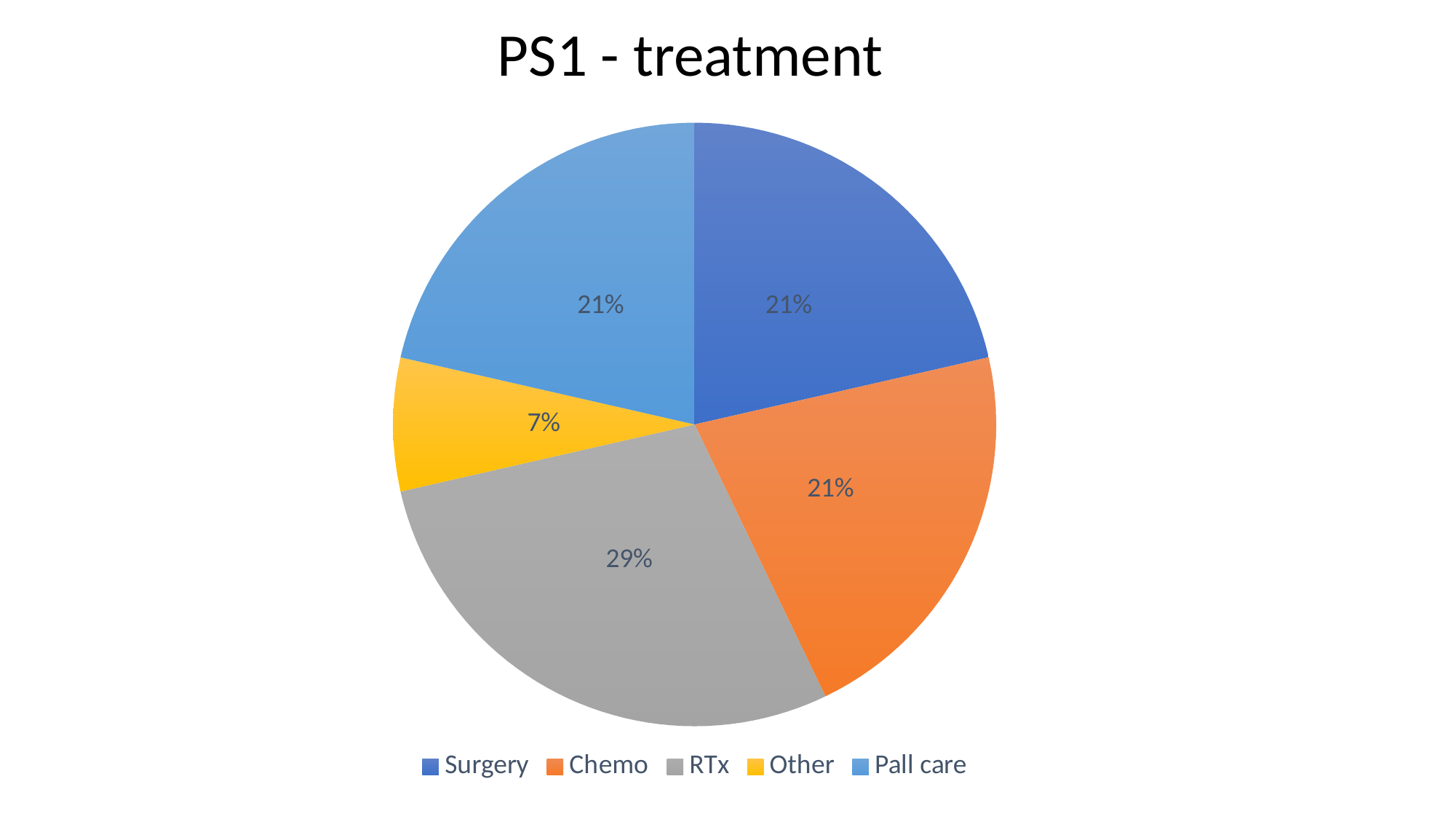
What kind of chart is shown on the slide? Pie chart Which is larger, the RTx slice or the Chemo slice? RTx Which category has the largest slice of the pie? RTx What share of the pie does Other have? 7% What is the difference in percentage points between the RTx slice and the Other slice? 22 What share of the pie does Chemo have? 21% Which category has the smallest slice of the pie? Other How many categories are shown in the pie chart? 5 What share of the pie does Surgery have? 21% What is the title of the chart? PS1 - treatment What share of the pie does Pall care have? 21% What share of the pie does RTx have? 29%